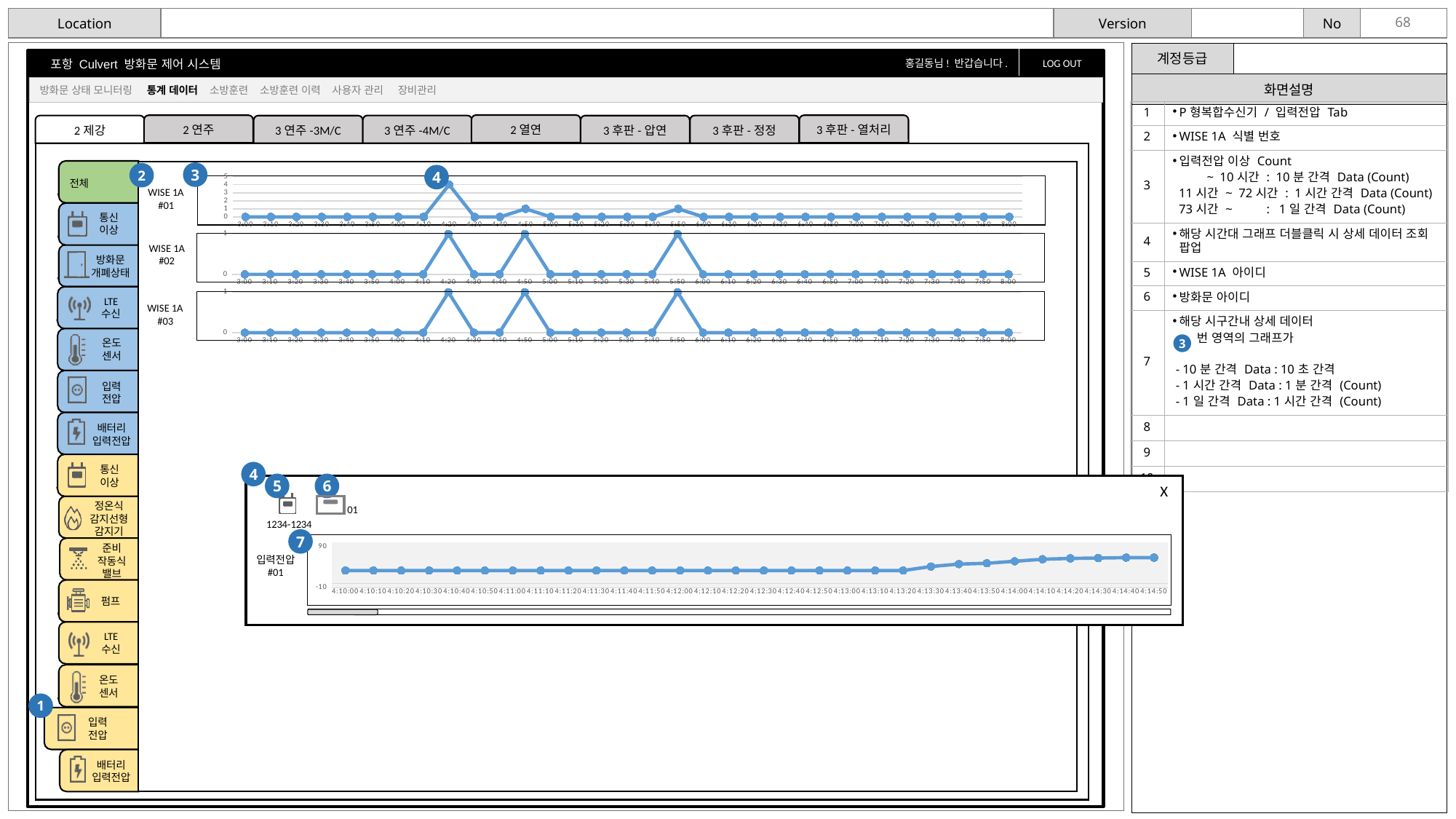
What is the first and last time label on the x axis of the WISE 1A #02 chart? 3:00 and 8:00 In the 입력전압 #01 chart in the popup, which is larger, the value at 4:10:00 or the value at 4:14:50? 4:14:50 In the WISE 1A #01 chart, which is larger, the value at 4:20 or the value at 4:50? 4:20 In the 입력전압 #01 chart in the popup, is the value at 4:10:00 greater or less than 90? less In the WISE 1A #01 chart, at which time does the line reach its highest point? 4:20 In the 입력전압 #01 chart in the popup, does the line rise or fall toward the right end of the x axis? rises In the WISE 1A #02 chart, what is the value at 3:00? 0 In the WISE 1A #01 chart, is the value at 4:20 greater or less than 3? greater In the WISE 1A #03 chart, how many times does the line rise to 1? 3 What kind of chart is the WISE 1A #01 chart at the top of the slide? line chart In the WISE 1A #02 chart, what is the value at 4:20? 1 In the WISE 1A #03 chart, at which times does the line reach 1? 4:20, 4:50, 5:50